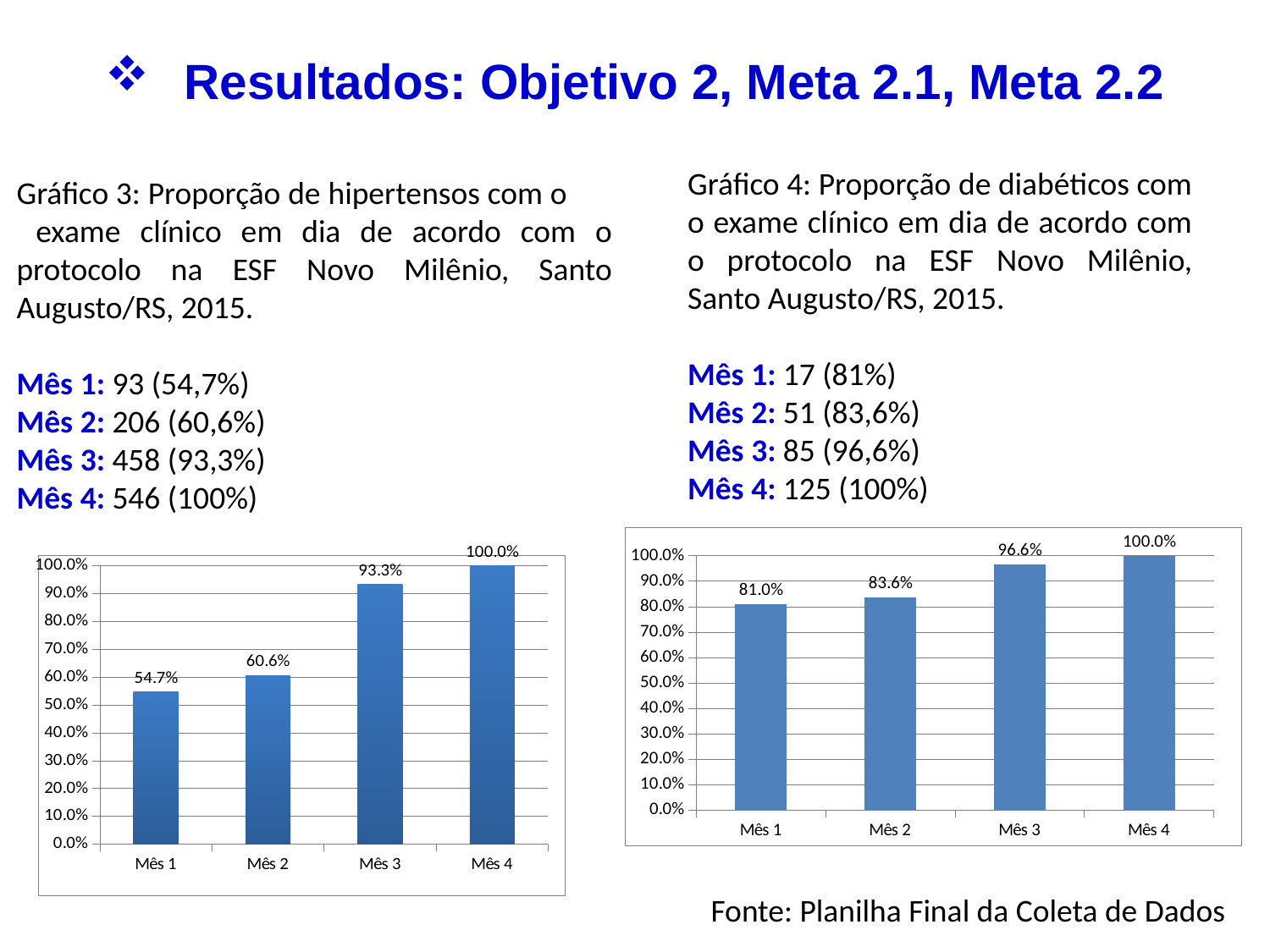
In the left chart (Gráfico 3, hipertensos), what is the value for Mês 2? 60.6% In the left chart (Gráfico 3, hipertensos), which is larger: the value for Mês 1 or Mês 2? Mês 2 In the left chart (Gráfico 3, hipertensos), what is the difference between the values for Mês 3 and Mês 2? 32.7% In the right chart (Gráfico 4, diabéticos), what is the value for Mês 1? 81.0% How many months are shown on the x axis of the left chart (Gráfico 3, hipertensos)? 4 In the left chart (Gráfico 3, hipertensos), do the values rise or fall from Mês 1 to Mês 4? Rise What kind of chart is the right chart (Gráfico 4, diabéticos)? Bar chart In the right chart (Gráfico 4, diabéticos), which month has the highest value? Mês 4 In the right chart (Gráfico 4, diabéticos), what is the difference between the values for Mês 3 and Mês 1? 15.6% In the right chart (Gráfico 4, diabéticos), is the value for Mês 2 greater or less than 90.0%? less In the left chart (Gráfico 3, hipertensos), which month has the lowest value? Mês 1 In the right chart (Gráfico 4, diabéticos), what is the value for Mês 3? 96.6%